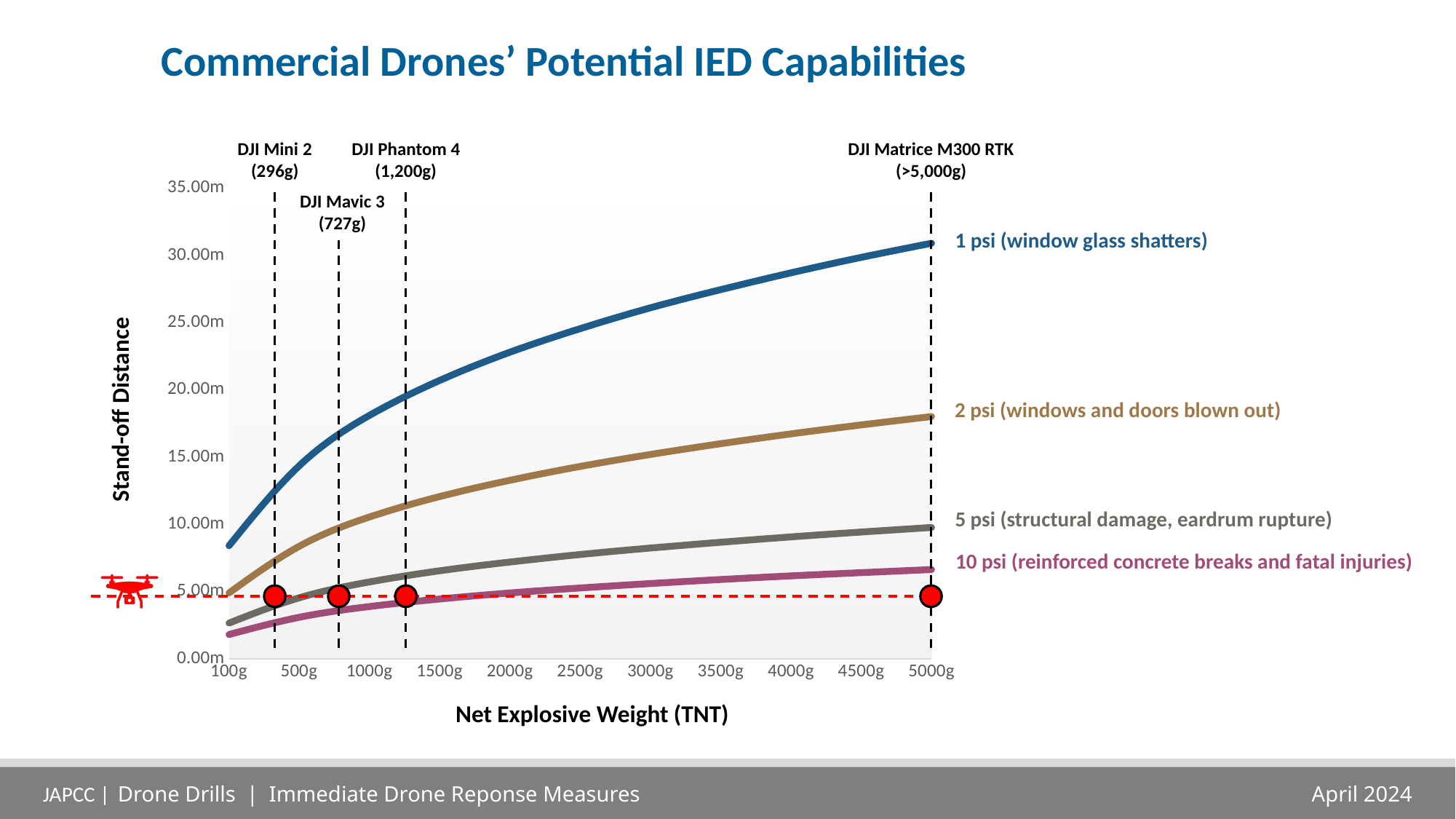
Which series has the highest stand-off distance across the chart? 1 psi (window glass shatters) Is the stand-off distance for the 1 psi line at 5000g greater or less than 25.00m? greater Which series has the lowest stand-off distance across the chart? 10 psi (reinforced concrete breaks and fatal injuries) Is the stand-off distance for the 2 psi line at 5000g greater or less than 20.00m? less What is the title of the x axis? Net Explosive Weight (TNT) Do the stand-off distances rise or fall as net explosive weight increases along the x axis? Rise What explosive weight is annotated for the DJI Phantom 4 on the chart? 1,200g How many psi overpressure series (lines) are plotted on the chart? 4 What kind of chart is shown on the slide? Line chart At 5000g, which line shows a larger stand-off distance: 1 psi or 2 psi? 1 psi Is the stand-off distance for the 10 psi line at 5000g greater or less than 10.00m? less